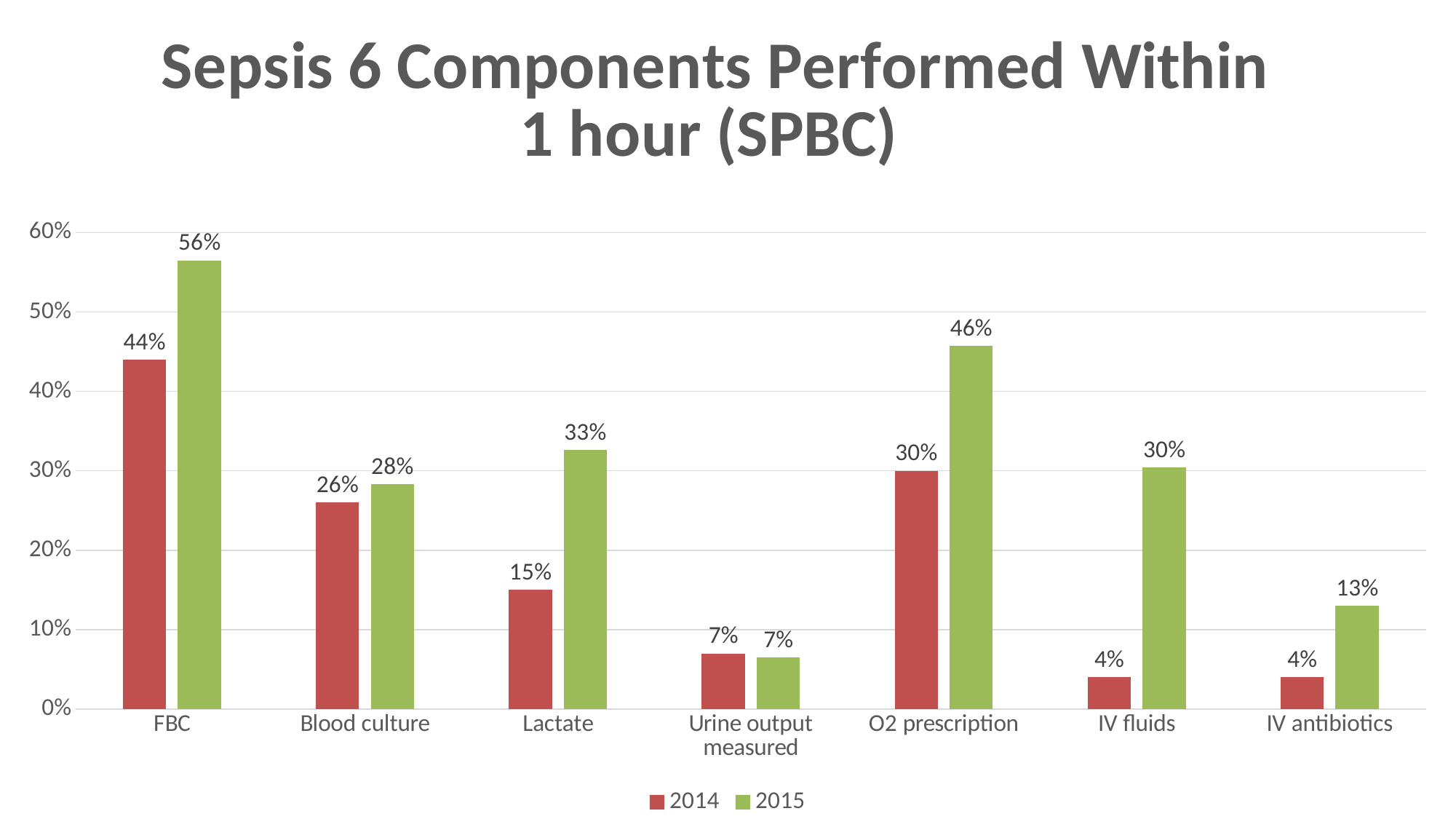
Which category has the lowest 2015 value? Urine output measured What is the 2015 value for FBC? 56% What is the 2015 value for IV antibiotics? 13% What is the 2014 value for Lactate? 15% Which is larger for IV fluids, the 2014 value or the 2015 value? 2015 How many series does the legend list? 2 Which category has the highest 2015 value? FBC What is the title of the chart? Sepsis 6 Components Performed Within 1 hour (SPBC) What kind of chart is shown on the slide? Bar chart How many categories are shown on the x axis? 7 Is the 2014 value for FBC greater or less than 40%? greater What is the difference between the 2015 and 2014 values for O2 prescription? 16%